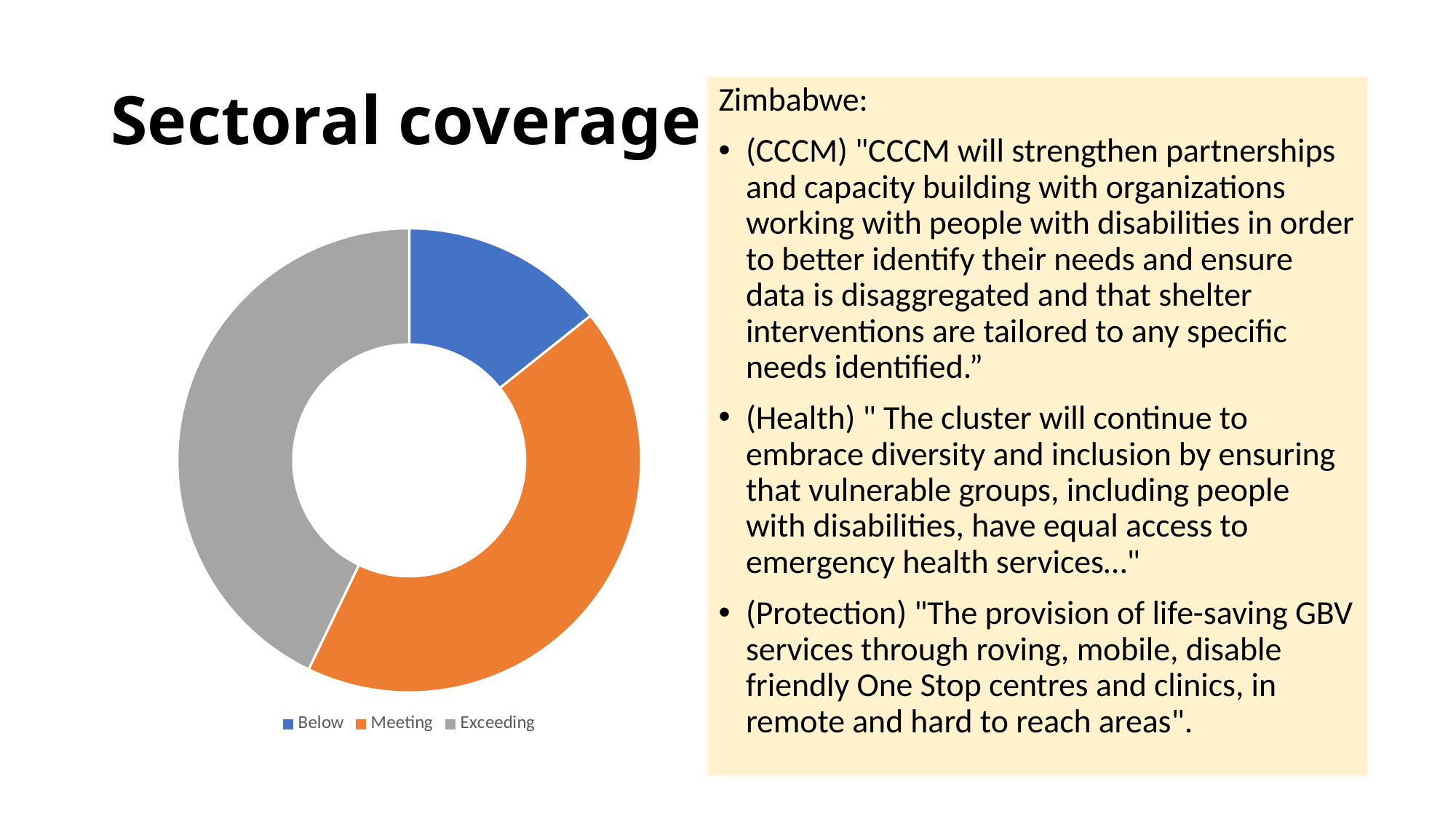
Which category has the smallest share of the doughnut chart? Below Which is larger in the doughnut chart, Below or Exceeding? Exceeding How many entries does the legend of the doughnut chart list? 3 How many categories does the doughnut chart show? 3 Which colour represents the Meeting category in the doughnut chart? Orange Which is larger in the doughnut chart, Below or Meeting? Meeting What are the three categories listed in the legend of the doughnut chart? Below, Meeting, Exceeding What kind of chart is shown on the slide? Doughnut chart